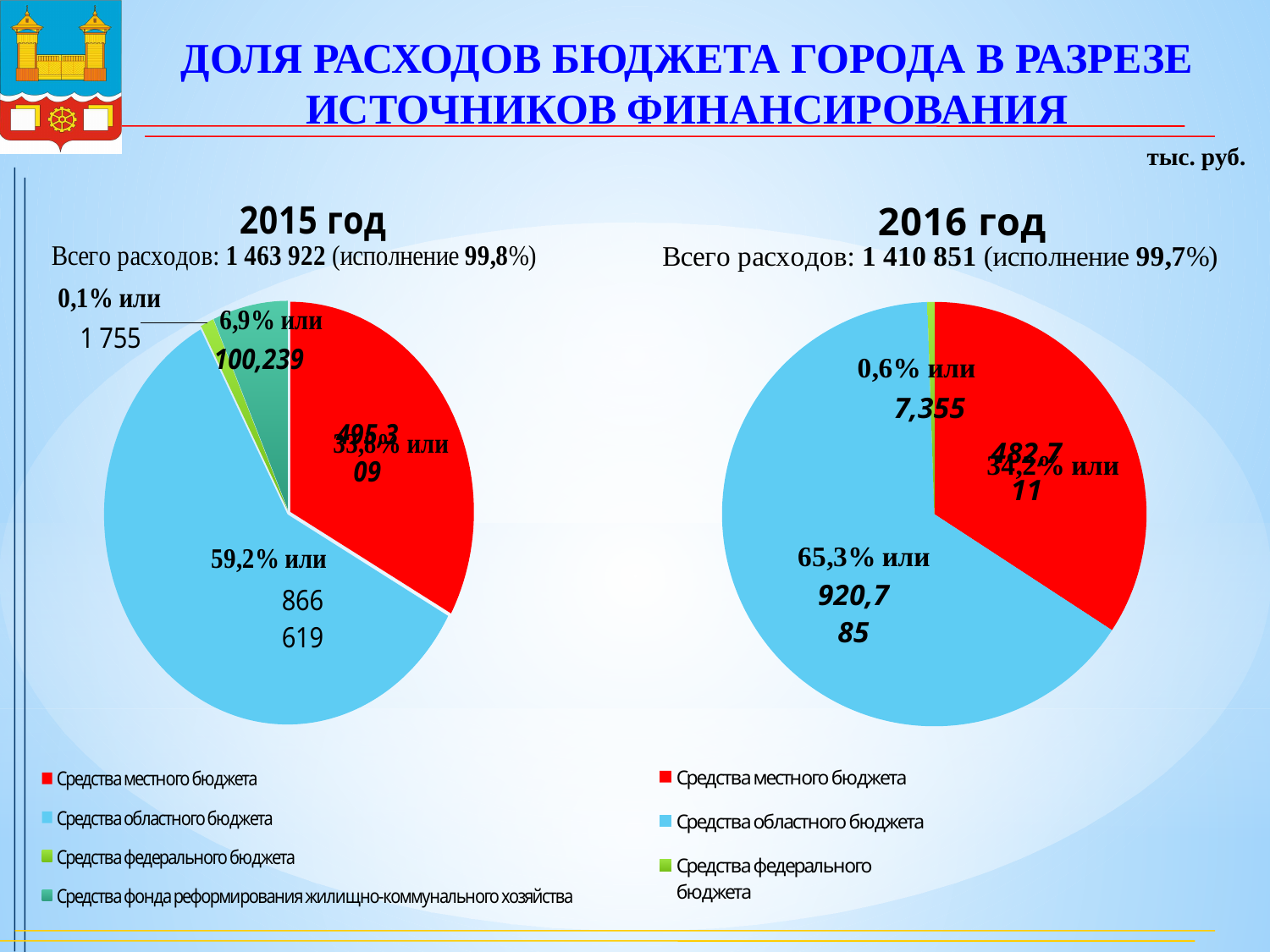
In the 2015 год chart, which source has the largest share? Средства областного бюджета In the 2015 год chart, which source has the smallest share? Средства федерального бюджета How many slices does the 2016 год pie chart have? 3 In the 2016 год chart, what share is labelled for Средства местного бюджета? 34,2% How many entries does the legend of the 2015 год chart list? 4 In the 2016 год chart, what share of expenditures comes from Средства областного бюджета? 65,3% In the 2015 год chart, what share is labelled for Средства федерального бюджета? 0,1% In the 2016 год chart, which is larger: the share of Средства местного бюджета or Средства областного бюджета? Средства областного бюджета What kind of chart is used for the 2015 год chart? pie chart In the 2015 год chart, what is the value for Средства фонда реформирования жилищно-коммунального хозяйства? 100,239 In the 2016 год chart, what is the value for Средства федерального бюджета? 7,355